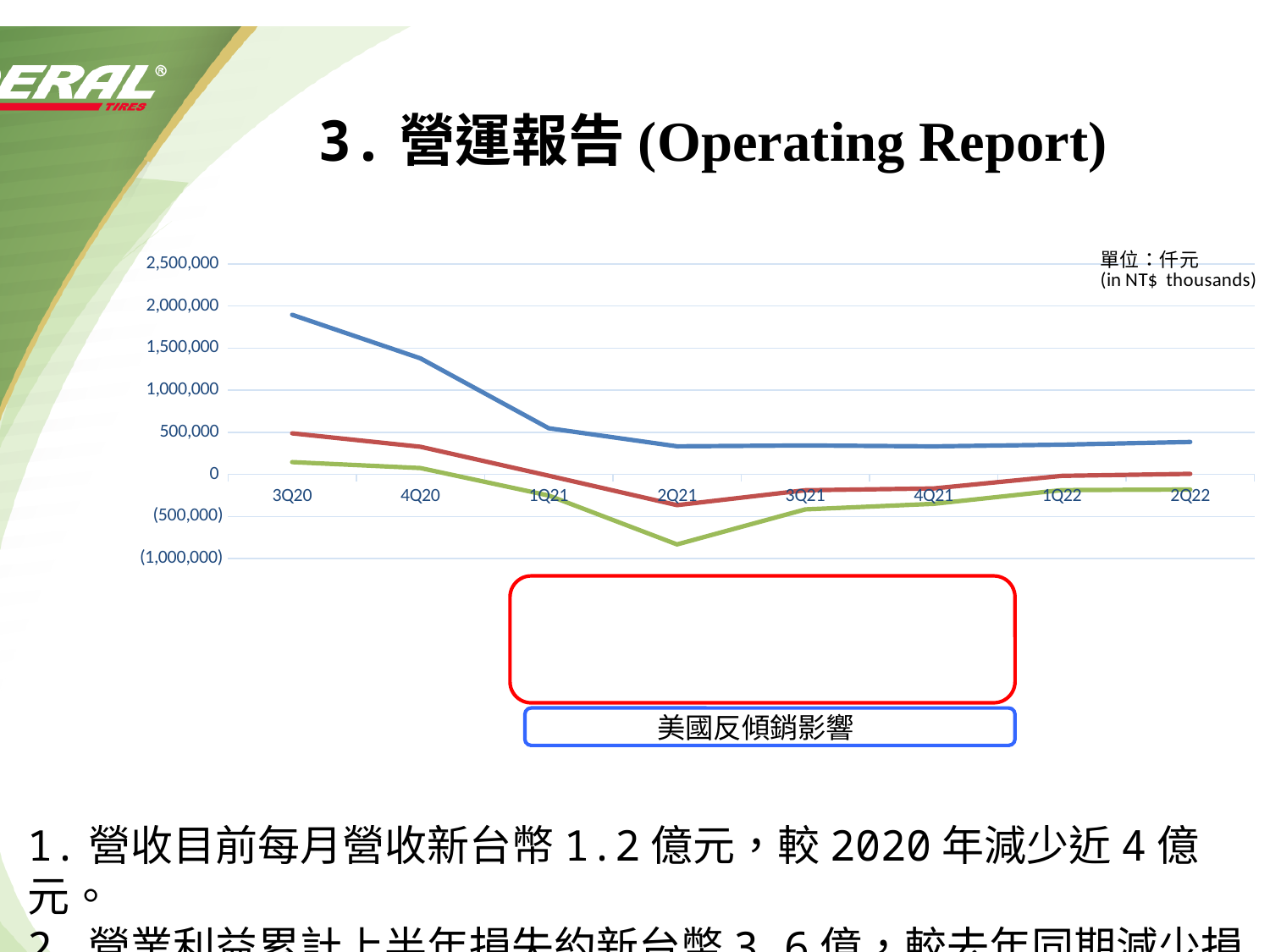
Is the value of the red line at 2Q21 greater or less than 0? less Does the blue line rise or fall from 3Q20 to 2Q21? fall At which quarter does the blue line reach its highest value? 3Q20 How many quarters are plotted along the x axis of the chart? 8 At which quarter does the green line reach its lowest value? 2Q21 Which is larger for the blue line, the value at 3Q20 or the value at 4Q20? 3Q20 What kind of chart is shown on the slide? line chart Is the value of the blue line at 3Q20 greater or less than 1,500,000? greater Is the value of the green line at 2Q21 greater or less than (500,000)? less What unit is stated in the top-right corner of the chart? 單位：仟元 (in NT$ thousands) At which quarter does the red line reach its lowest value? 2Q21